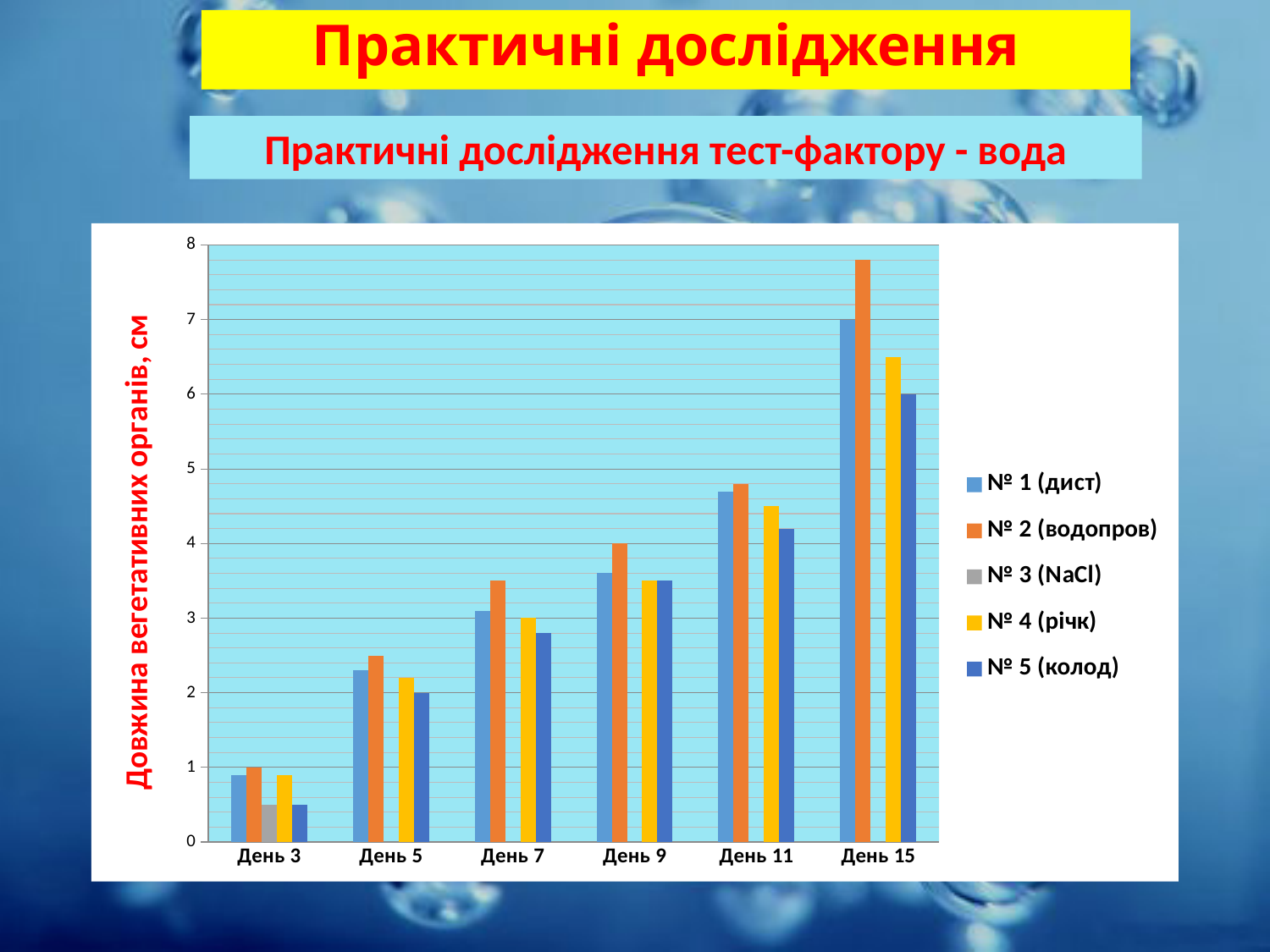
Which series has the highest bar on День 15? № 2 (водопров) What is the value for № 2 (водопров) on День 9? 4 Is the value for № 3 (NaCl) on День 3 greater or less than 1? less Is the value for № 2 (водопров) on День 15 greater or less than 7? greater How many series does the legend list? 5 Do the values for № 1 (дист) rise or fall from День 3 to День 15? rise What kind of chart is shown on the slide? bar chart What is the value for № 1 (дист) on День 15? 7 How many day categories are shown on the x axis? 6 What is the value for № 5 (колод) on День 15? 6 What is the value for № 5 (колод) on День 5? 2 What is the title of the vertical axis? Довжина вегетативних органів, см